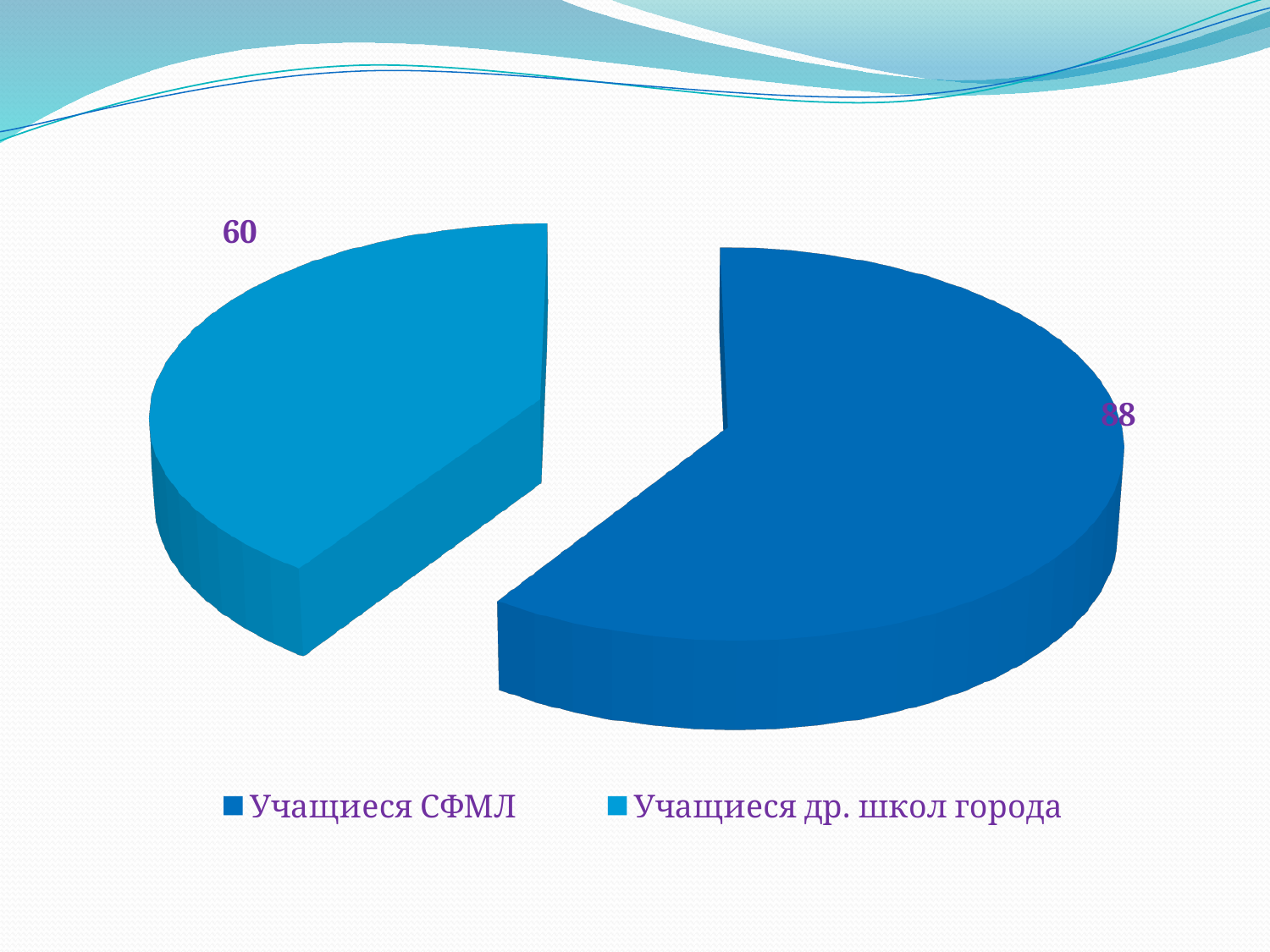
What is the value for Учащиеся СФМЛ? 88 What kind of chart is shown on the slide? pie chart Which is larger: the value for Учащиеся СФМЛ or the value for Учащиеся др. школ города? Учащиеся СФМЛ What colour is the slice for Учащиеся др. школ города? light blue Which category has the largest slice of the pie? Учащиеся СФМЛ Which category has the smallest slice of the pie? Учащиеся др. школ города How many entries does the legend list? 2 What is the difference between the values for Учащиеся СФМЛ and Учащиеся др. школ города? 28 Where is the legend positioned on the slide? below the chart What is the value for Учащиеся др. школ города? 60 How many slices does the pie chart have? 2 What is the total of the two values shown on the pie chart? 148